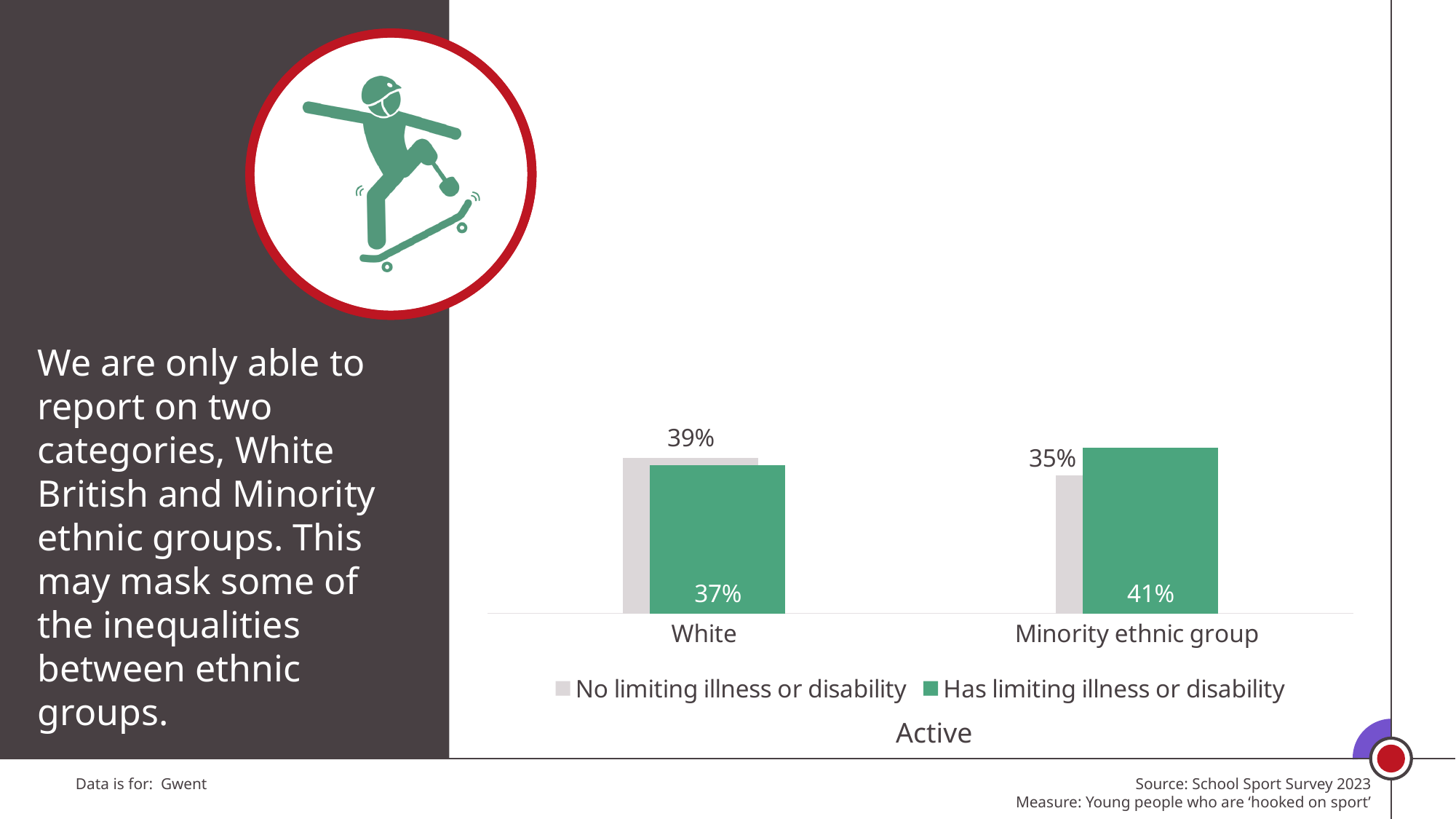
Which category has the highest value for 'Has limiting illness or disability'? Minority ethnic group What is the difference between the 'Has limiting illness or disability' and 'No limiting illness or disability' values in the Minority ethnic group category? 6% In the White category, which is larger: 'No limiting illness or disability' or 'Has limiting illness or disability'? No limiting illness or disability How many series does the legend list? 2 What is the value for 'Has limiting illness or disability' in the Minority ethnic group category? 41% How many categories are shown on the x axis? 2 Which category has the lowest value for 'No limiting illness or disability'? Minority ethnic group What is the value for 'No limiting illness or disability' in the White category? 39% What is the value for 'Has limiting illness or disability' in the White category? 37% What kind of chart is shown on the slide? Bar chart What is the value for 'No limiting illness or disability' in the Minority ethnic group category? 35% What is the difference between the 'No limiting illness or disability' values for White and Minority ethnic group? 4%